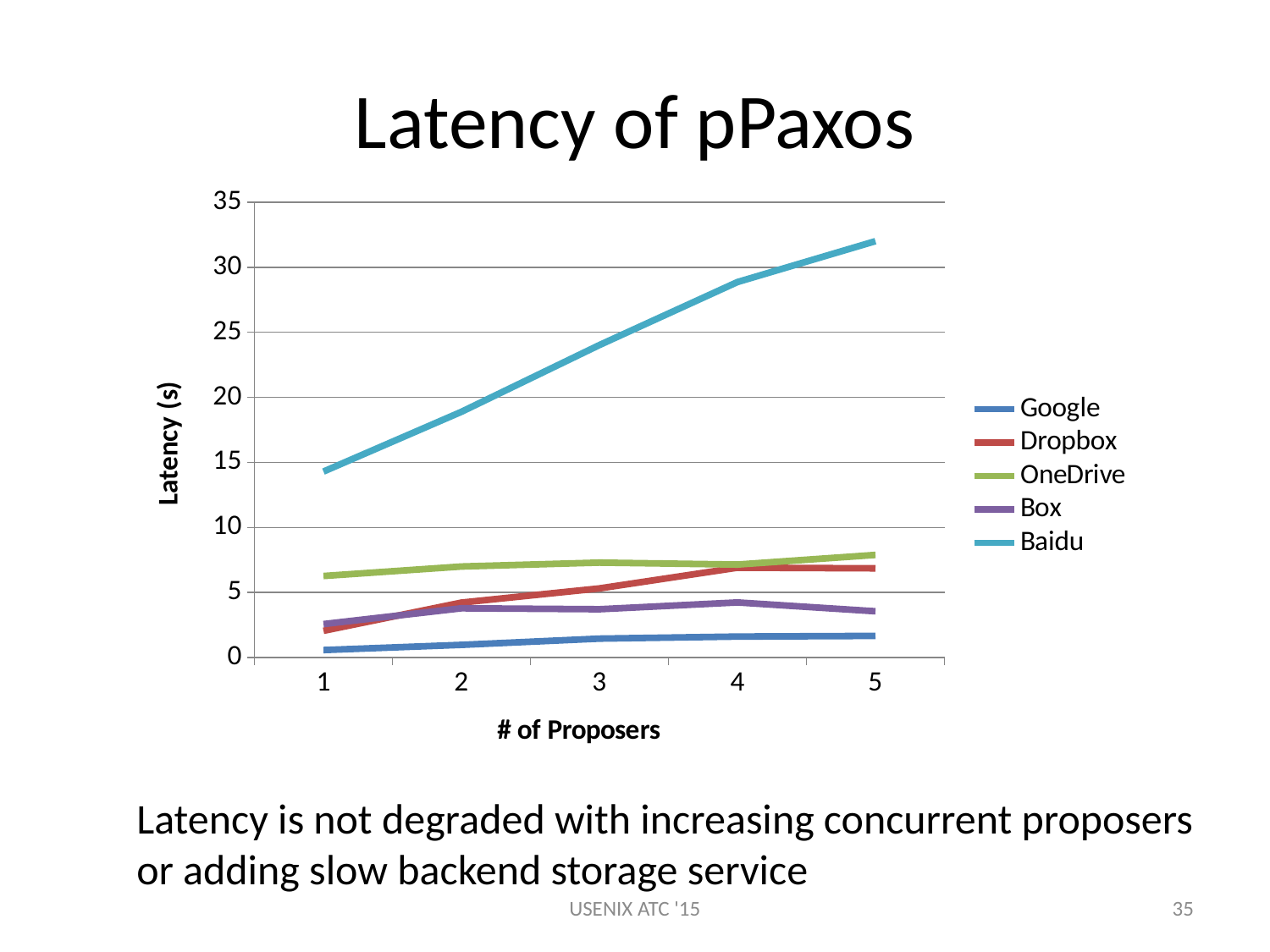
Is the latency for Baidu at 1 proposer greater or less than 10? greater How many values of # of Proposers are plotted along the x axis? 5 Does the latency for Baidu rise or fall as the number of proposers increases? rise At 1 proposer, which has the higher latency, OneDrive or Dropbox? OneDrive Is the latency for Baidu at 5 proposers greater or less than 30? greater How many series does the legend list? 5 What is the title of the y axis? Latency (s) Which service has the highest latency at 5 proposers? Baidu What kind of chart is shown on the slide? line chart Is the latency for Google at 1 proposer greater or less than 5? less What is the title of the chart? Latency of pPaxos Which service has the lowest latency at 1 proposer? Google